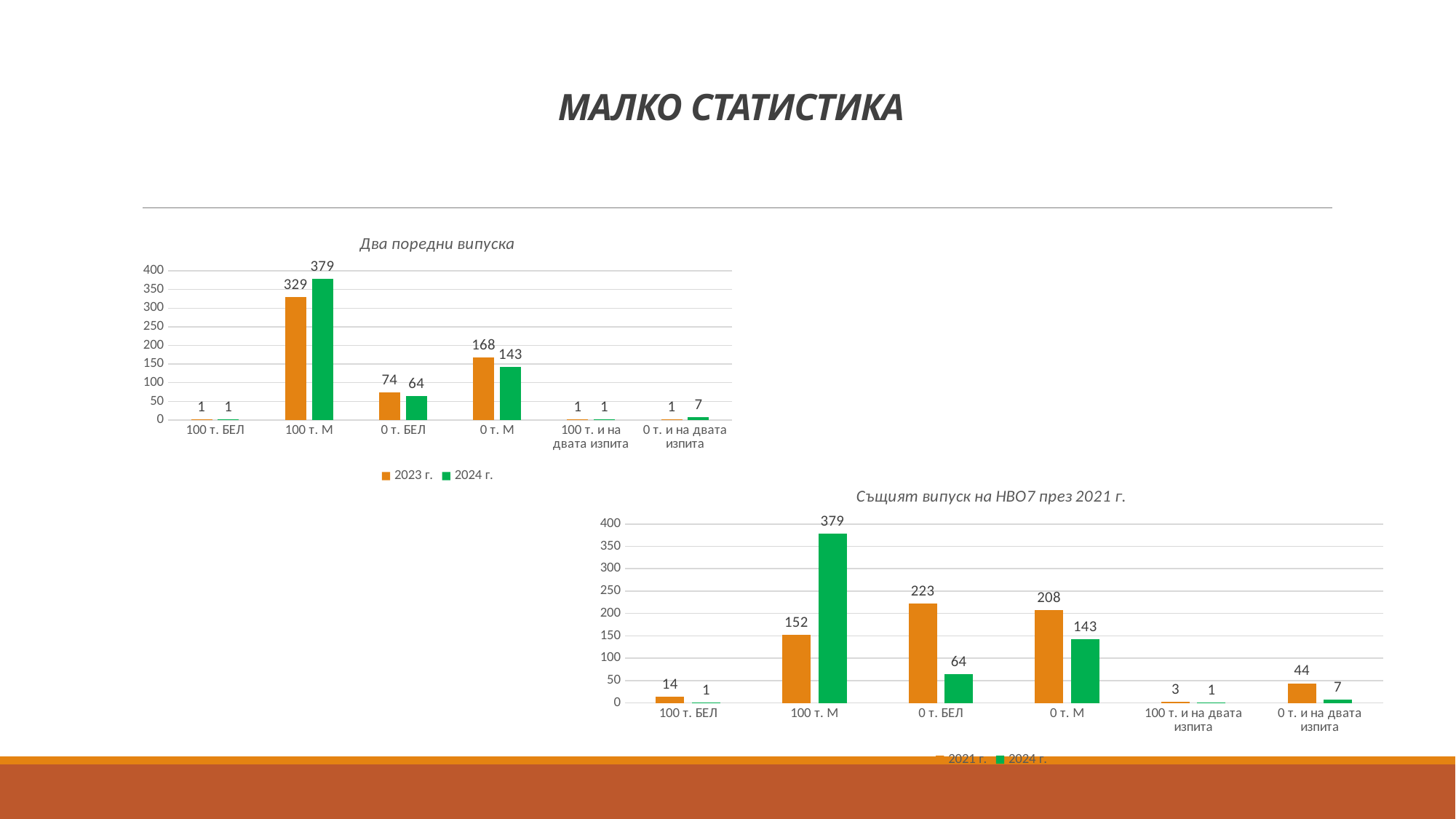
In the chart 'Два поредни випуска', how many series does the legend list? 2 In the chart 'Същият випуск на НВО7 през 2021 г.', what is the value for 2021 г. in the category '0 т. БЕЛ'? 223 In the chart 'Два поредни випуска', which category has the highest value for 2023 г.? 100 т. М In the chart 'Същият випуск на НВО7 през 2021 г.', what is the value for 2021 г. in the category '0 т. и на двата изпита'? 44 In the chart 'Същият випуск на НВО7 през 2021 г.', which is larger for '100 т. М': the 2021 г. value or the 2024 г. value? 2024 г. In the chart 'Два поредни випуска', what is the value for 2024 г. in the category '100 т. М'? 379 What type of chart is 'Два поредни випуска'? Bar chart How many categories are shown on the x axis of the chart 'Същият випуск на НВО7 през 2021 г.'? 6 In the chart 'Два поредни випуска', what is the difference between the 2023 г. and 2024 г. values for '0 т. М'? 25 In the chart 'Същият випуск на НВО7 през 2021 г.', which category has the lowest value for 2021 г.? 100 т. и на двата изпита In the chart 'Същият випуск на НВО7 през 2021 г.', what is the difference between the 2021 г. and 2024 г. values for '0 т. БЕЛ'? 159 In the chart 'Два поредни випуска', what is the value for 2023 г. in the category '0 т. БЕЛ'? 74